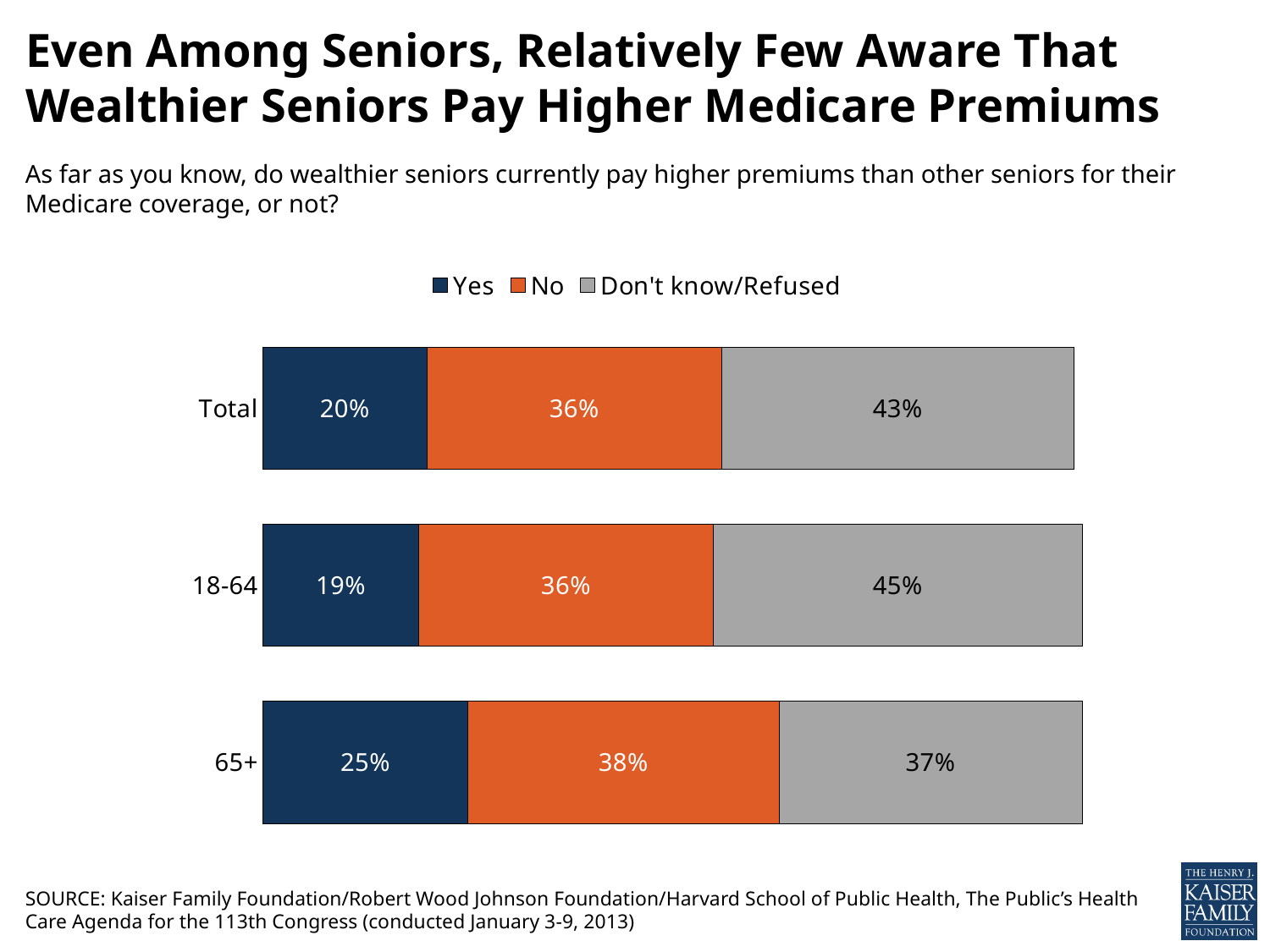
What is the total of the three segments in the 65+ bar? 100% What kind of chart is shown on the slide? Stacked bar chart What percentage of the 18-64 group answered Don't know/Refused? 45% What is the difference between the Yes percentage for 65+ and the Yes percentage for 18-64? 6 percentage points How many groups are shown on the chart? 3 Which age group has the highest Yes percentage? 65+ How many series does the legend list? 3 Which colour represents the No response in the chart? Orange What percentage of the 65+ group answered No? 38% Which group has the lowest Don't know/Refused percentage? 65+ What percentage of the Total group answered Yes? 20% Which is larger: the Don't know/Refused share for Total or for 65+? Total